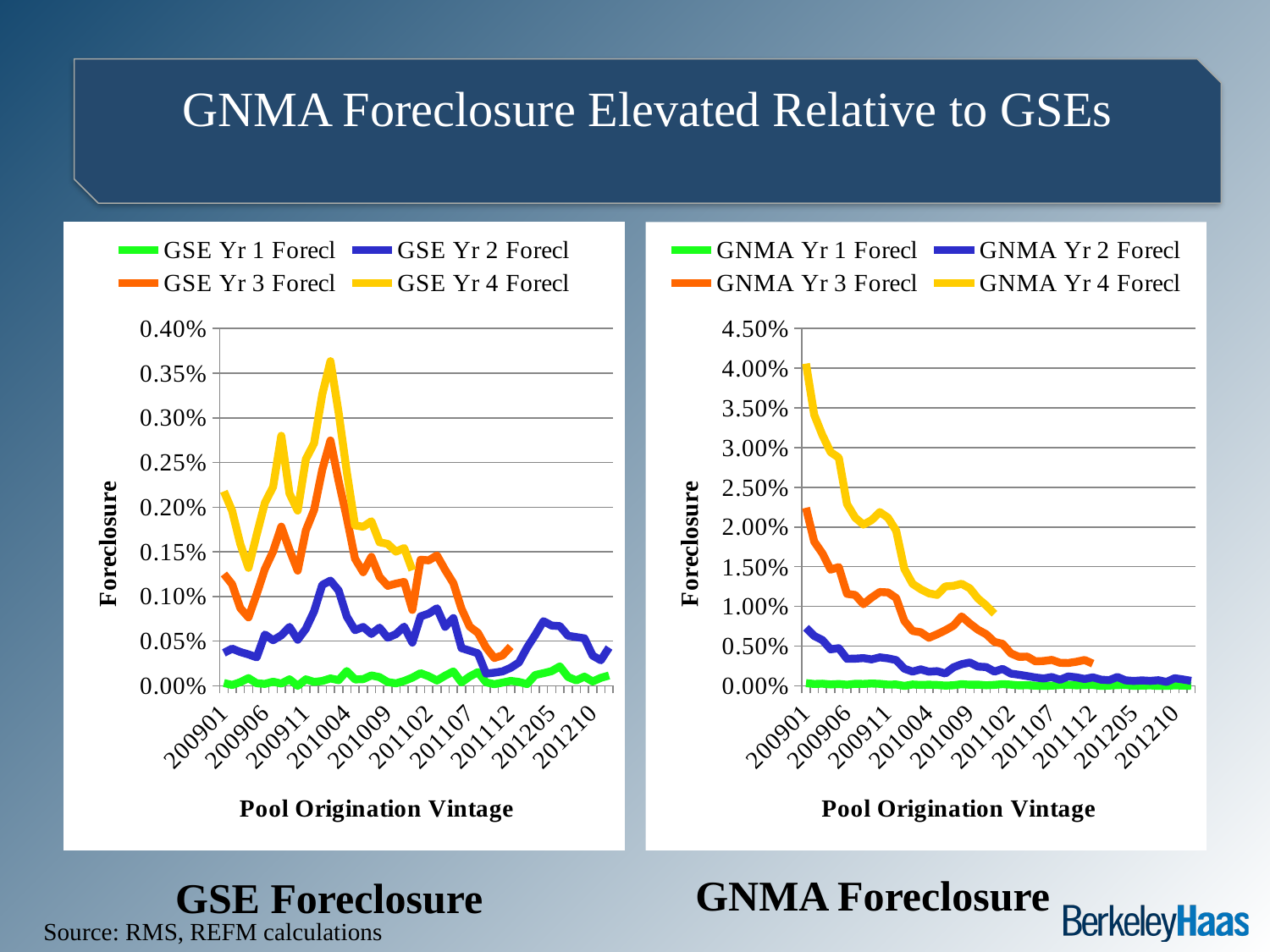
In the GNMA Foreclosure chart, does GNMA Yr 4 Forecl rise or fall along the x axis? fall How many vintage labels are shown on the x axis of the GSE Foreclosure chart? 10 In the GNMA Foreclosure chart, which series stays lowest across the x axis? GNMA Yr 1 Forecl What is the highest value shown on the y axis of the GNMA Foreclosure chart? 4.50% In the GSE Foreclosure chart, is the peak value of GSE Yr 4 Forecl greater or less than 0.30%? greater In the GNMA Foreclosure chart, is the value of GNMA Yr 3 Forecl at 200901 greater or less than 2.00%? greater In the GNMA Foreclosure chart, which is larger at 200906: GNMA Yr 4 Forecl or GNMA Yr 2 Forecl? GNMA Yr 4 Forecl In the GSE Foreclosure chart, which series reaches the highest value? GSE Yr 4 Forecl What kind of chart is the GSE Foreclosure chart on the left? line chart What is the x-axis title of the GSE Foreclosure chart? Pool Origination Vintage In the GNMA Foreclosure chart, is the value of GNMA Yr 4 Forecl at 200901 greater or less than 3.50%? greater How many series does the legend of the GNMA Foreclosure chart list? 4